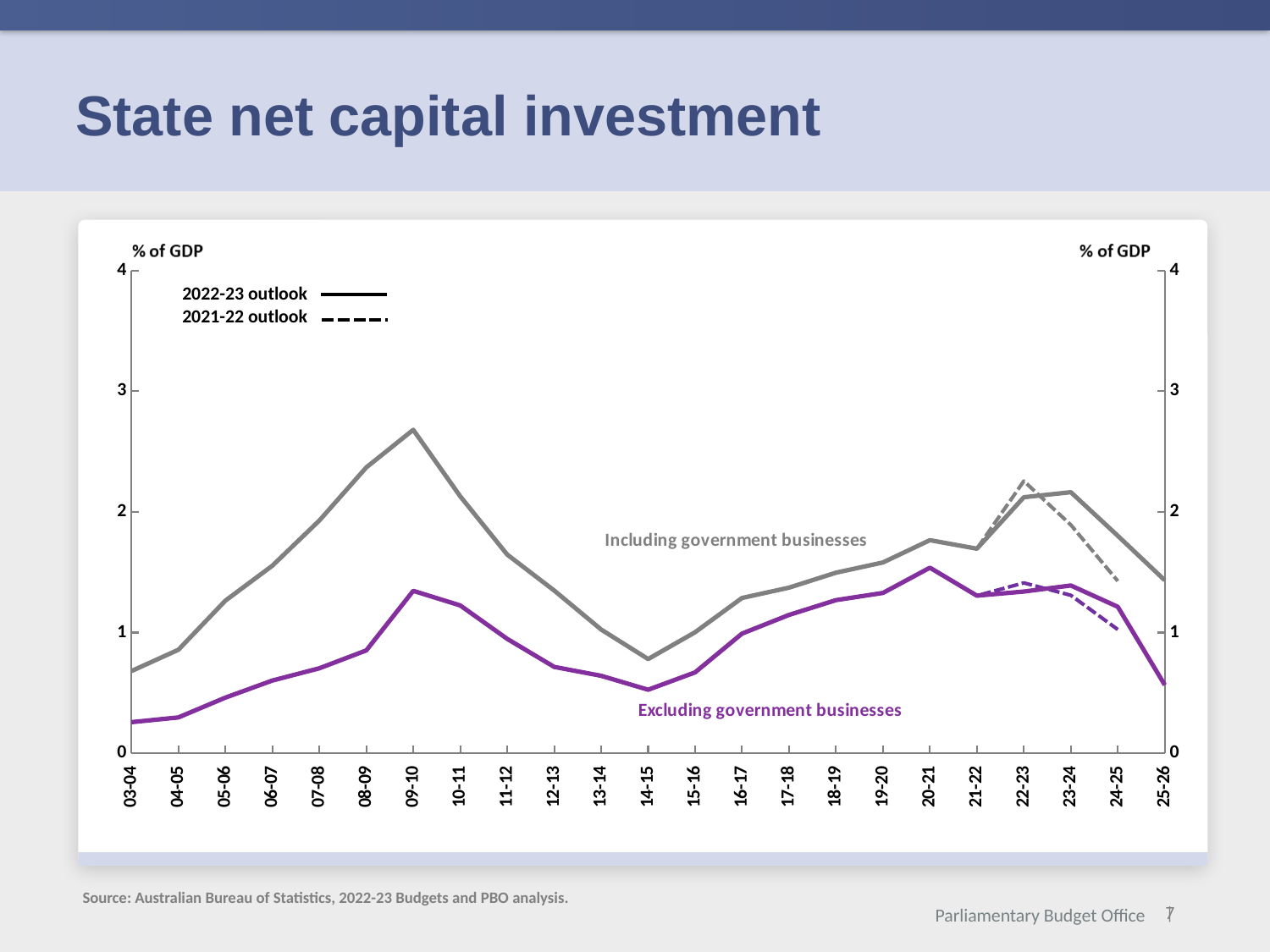
In which year does the 'Including government businesses' line reach its highest value? 09-10 Does the 'Including government businesses' line rise or fall between 09-10 and 14-15? fall How many outlook entries does the legend list? 2 Is the value for 'Excluding government businesses' in 20-21 greater or less than 1? greater Is the value for 'Including government businesses' in 14-15 greater or less than 1? less Is the value for 'Excluding government businesses' in 09-10 greater or less than 2? less What unit is shown on the y axis of the chart? % of GDP How many financial years are shown along the x axis? 23 What kind of chart is shown on the slide? line chart In 09-10, which line is higher: 'Including government businesses' or 'Excluding government businesses'? Including government businesses